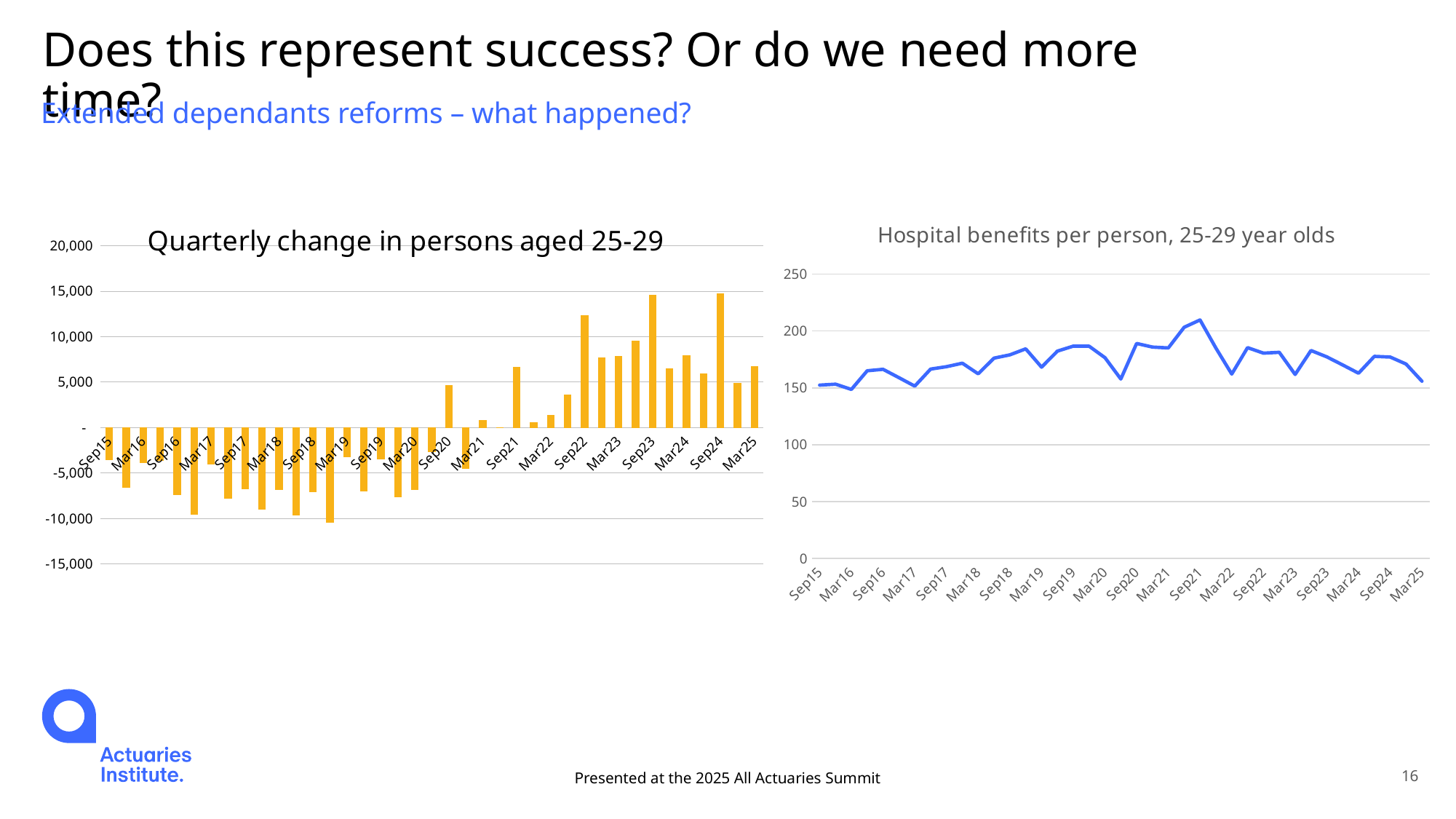
In the 'Hospital benefits per person, 25-29 year olds' chart, do values generally rise or fall from Sep15 to Sep21? rise What kind of chart is the 'Hospital benefits per person, 25-29 year olds' chart on the right? line chart In the 'Quarterly change in persons aged 25-29' chart, is the value for Sep15 greater or less than 0? less In the 'Quarterly change in persons aged 25-29' chart, is the value for Mar25 greater or less than 5,000? greater In the 'Hospital benefits per person, 25-29 year olds' chart, is the value for Sep21 greater or less than 200? greater In the 'Hospital benefits per person, 25-29 year olds' chart, which is larger, the value for Sep21 or the value for Mar22? Sep21 In the 'Hospital benefits per person, 25-29 year olds' chart, which quarter has the highest value? Sep21 What colour are the bars in the 'Quarterly change in persons aged 25-29' chart? orange What kind of chart is the 'Quarterly change in persons aged 25-29' chart on the left? bar chart